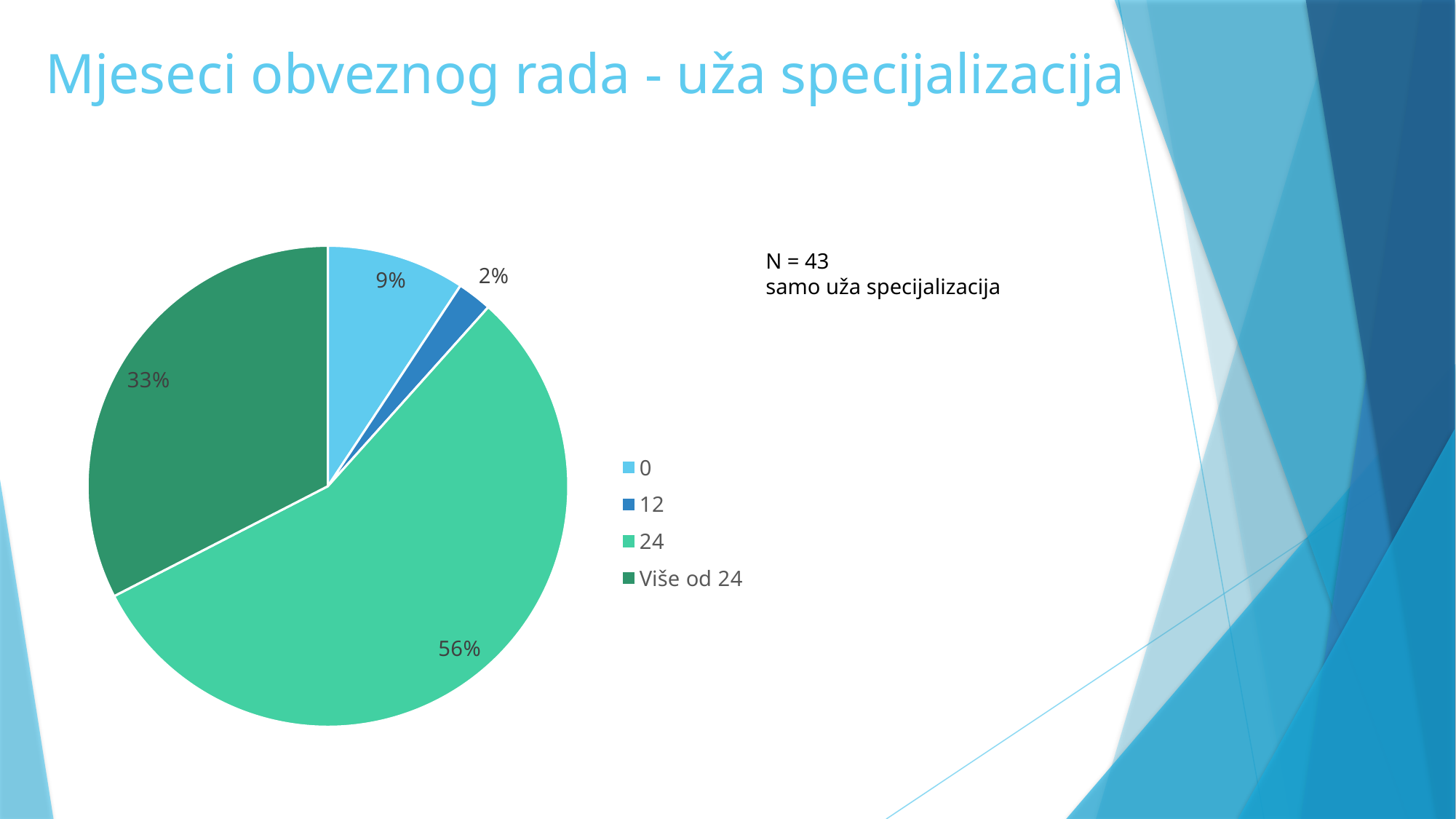
What is the difference in percentage points between the "24" slice and the "Više od 24" slice? 23 What share of the pie does the "0" slice represent? 9% What sample size (N) is stated next to the chart? N = 43 What share of the pie does the "Više od 24" slice represent? 33% Which category has the largest slice of the pie? 24 How many categories does the pie chart have? 4 What share of the pie does the "24" slice represent? 56% Which category has the smallest slice of the pie? 12 What kind of chart is shown on the slide? pie chart Which slice is larger, "0" or "12"? 0 What is the title of the slide containing the chart? Mjeseci obveznog rada - uža specijalizacija